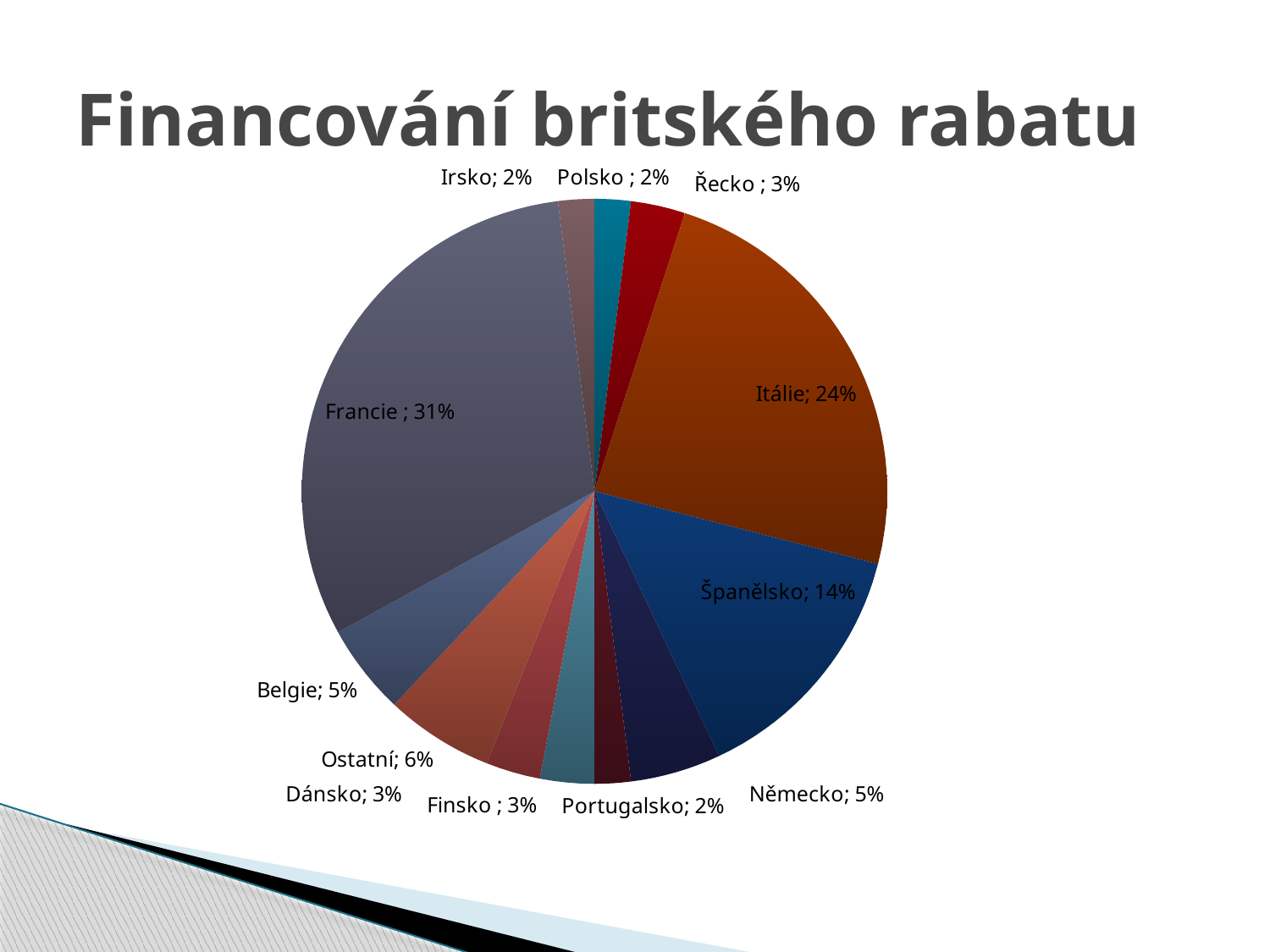
What is the difference between the shares of Francie and Itálie? 7% What is the value shown for Ostatní? 6% Which is larger, the share of Španělsko or the share of Německo? Španělsko Which category has the largest slice of the pie? Francie What is the value shown for Španělsko? 14% How many slices does the pie chart have? 12 What share of the pie does Francie have? 31% What is the difference between the shares of Itálie and Španělsko? 10% What is the value shown for Belgie? 5% What is the value shown for Itálie? 24% What kind of chart is shown on the slide? pie chart What is the title of the chart? Financování britského rabatu